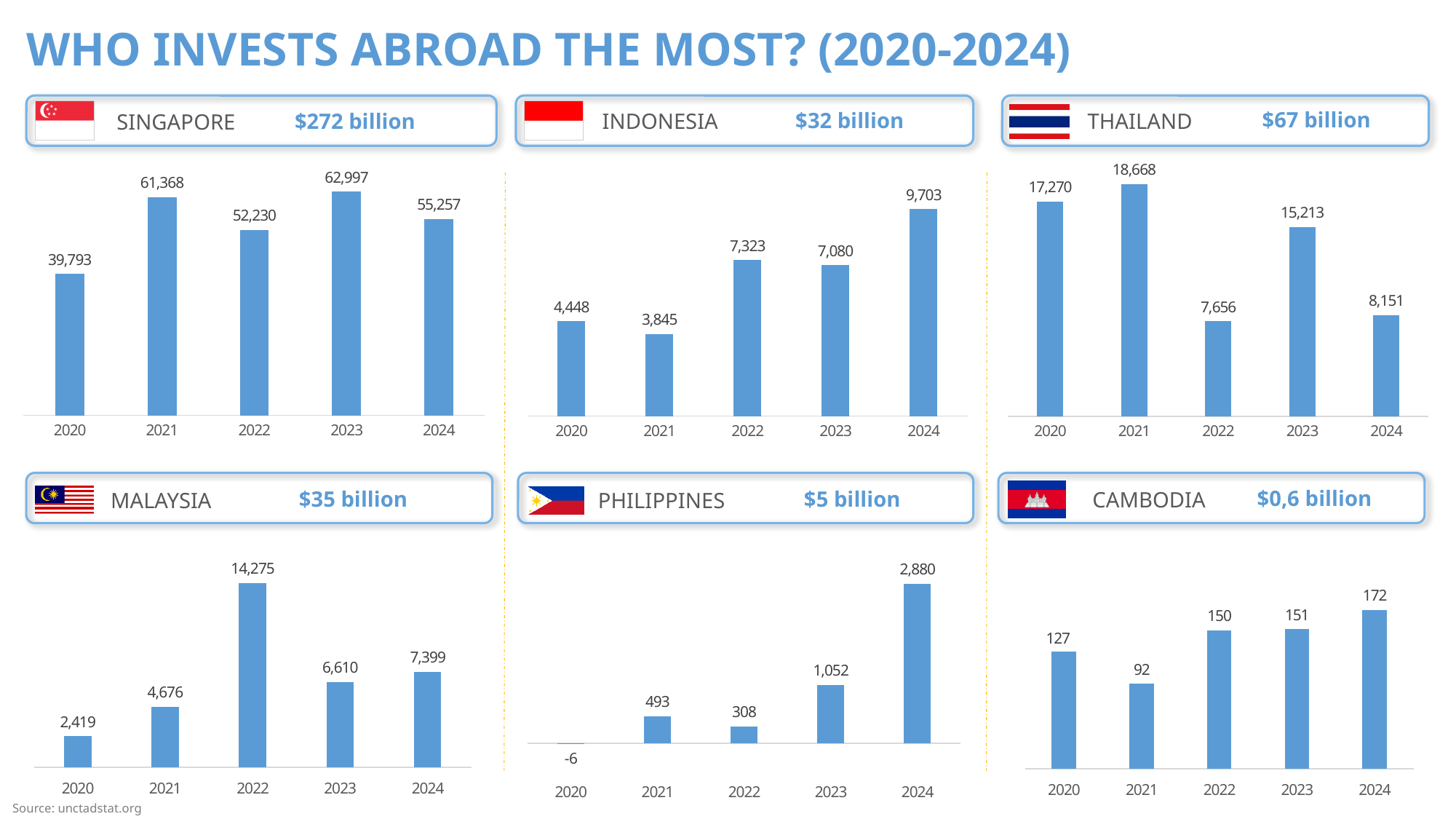
In the Philippines chart, what is the value for 2020? -6 In the Thailand chart, which year has the lowest value? 2022 What total is shown in the header for Thailand? $67 billion In the Cambodia chart, which is larger, the value for 2020 or the value for 2021? 2020 In the Indonesia chart, which year has the highest value? 2024 In the Malaysia chart, what is the difference between the 2022 value and the 2021 value? 9,599 In the Cambodia chart, do the values generally rise or fall from 2021 to 2024? Rise In the Singapore chart, what is the value for 2023? 62,997 How many years are plotted in the Singapore chart? 5 In the Indonesia chart, what is the difference between the 2024 value and the 2023 value? 2,623 What kind of chart is the Thailand chart? Bar chart What is the title of the slide? WHO INVESTS ABROAD THE MOST? (2020-2024)